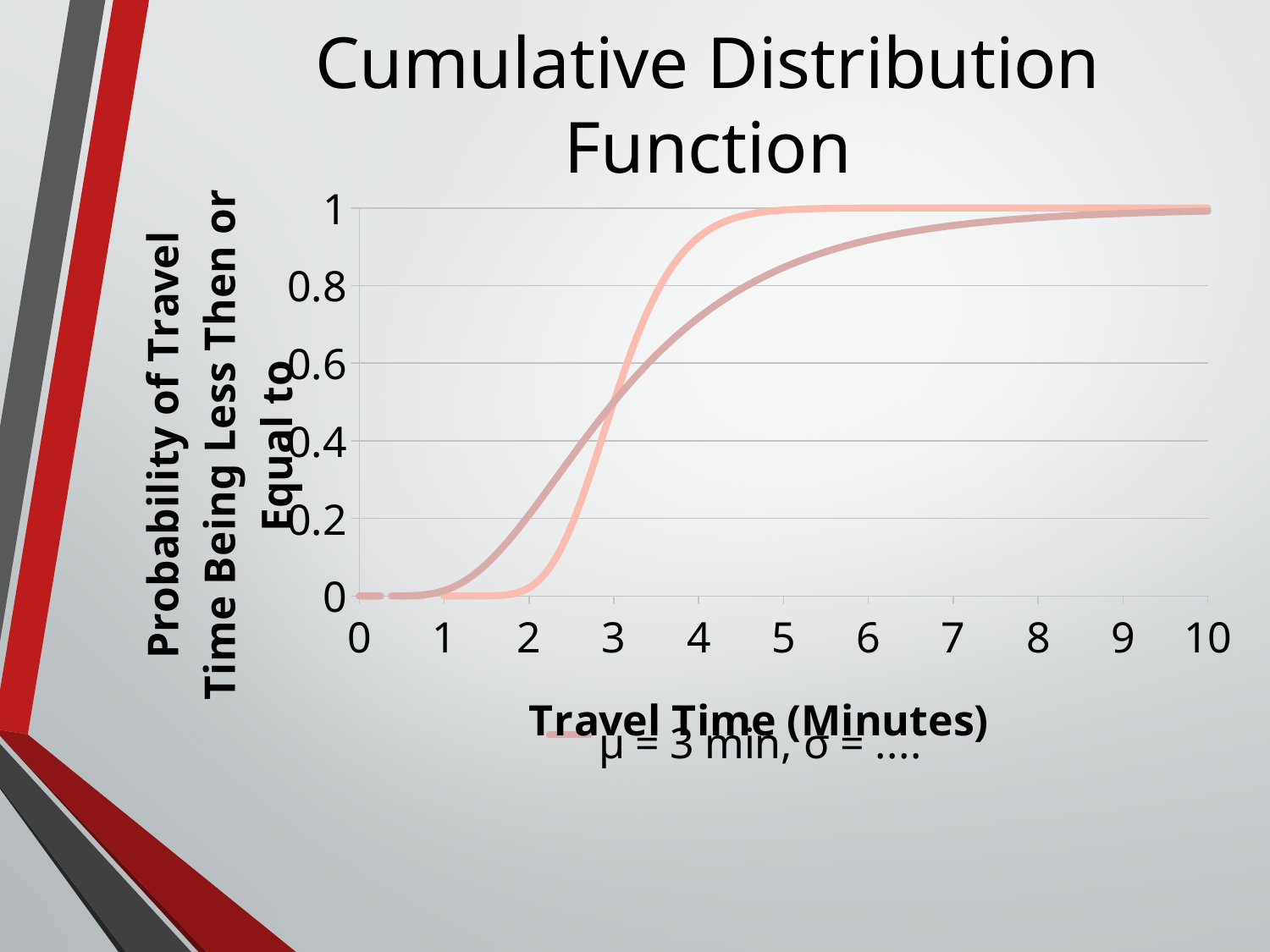
What is the x-axis title of the chart? Travel Time (Minutes) What kind of chart is shown on the slide? line chart How many curves are plotted on the chart? 2 At a travel time of 1 minute, is the value of the darker curve greater or less than 0.2? less At a travel time of 4 minutes, which curve has the higher value, the lighter peach curve or the darker curve? the lighter peach curve What is the title of the chart? Cumulative Distribution Function At a travel time of 6 minutes, is the value of the darker curve greater or less than 0.8? greater At a travel time of 2 minutes, is the value of the lighter peach curve greater or less than 0.2? less Do the plotted curves rise or fall as travel time increases along the x axis? rise What is the highest value shown on the x axis of the chart? 10 At a travel time of 2 minutes, which curve has the higher value, the lighter peach curve or the darker curve? the darker curve